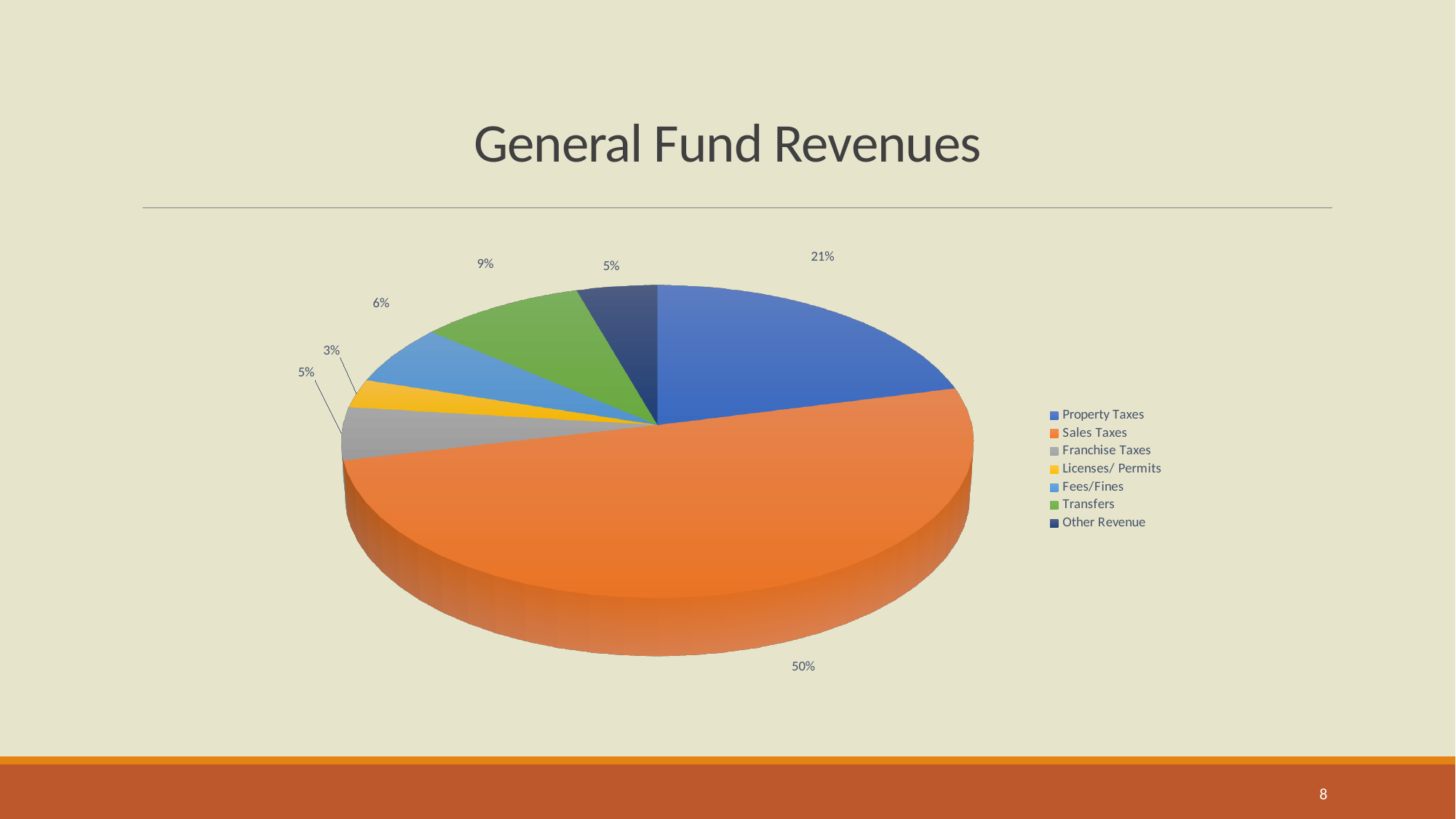
Which revenue category has the largest share of the pie? Sales Taxes What percentage is shown for Fees/Fines? 6% What kind of chart is shown on the slide? pie chart What percentage is shown for Transfers? 9% What share of General Fund Revenues comes from Property Taxes? 21% Which is larger, the share for Transfers or the share for Fees/Fines? Transfers Which revenue category has the smallest share of the pie? Licenses/ Permits What percentage is shown for Licenses/ Permits? 3% What share of General Fund Revenues comes from Sales Taxes? 50% How many categories does the legend list? 7 What is the difference in percentage points between Sales Taxes and Property Taxes? 29 What is the title of the chart? General Fund Revenues